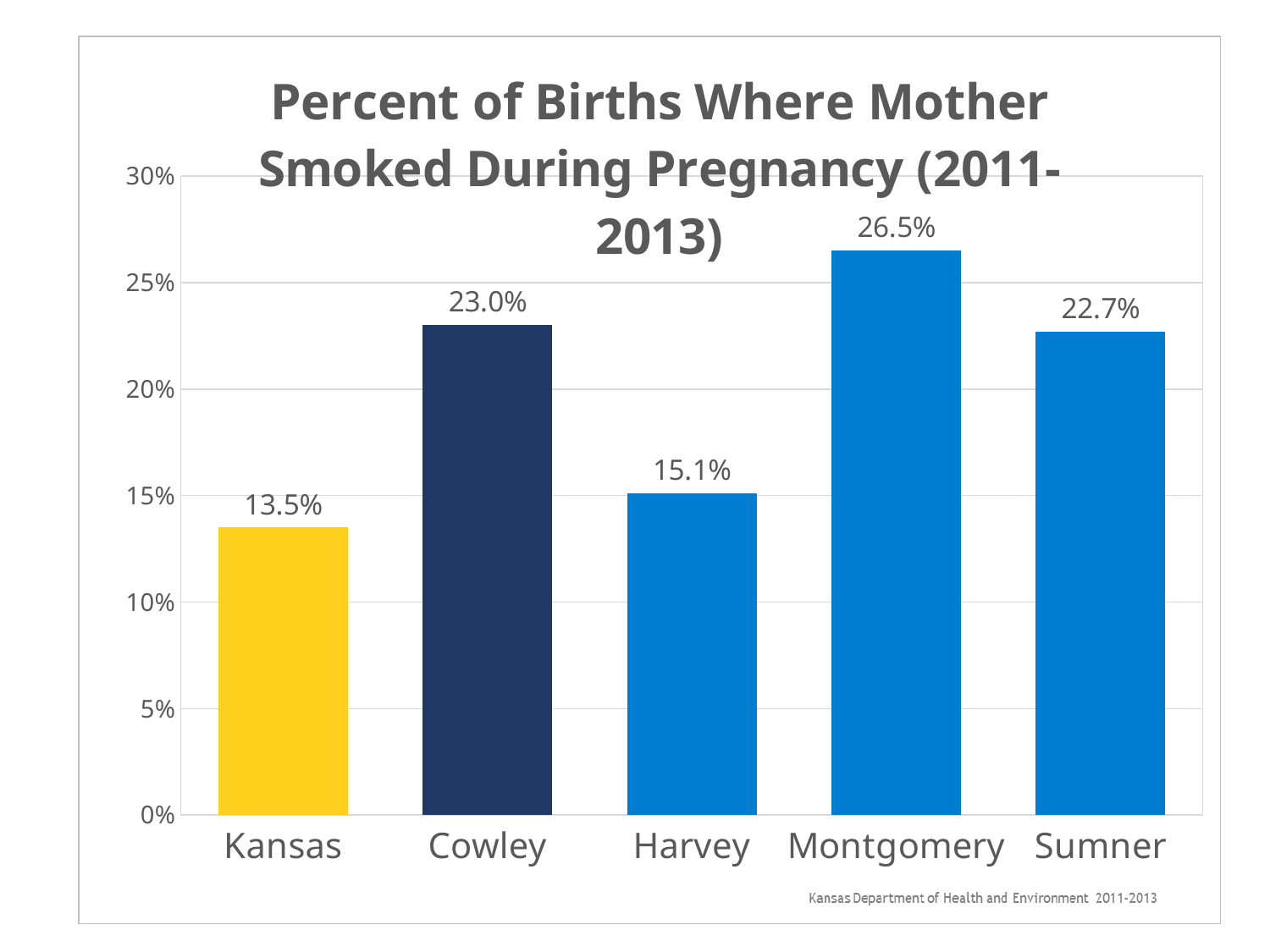
How many categories are shown on the chart? 5 Which has a higher value, Cowley or Harvey? Cowley What is the value shown for Montgomery? 26.5% What is the difference in percentage points between Cowley and Sumner? 0.3 What is the difference in percentage points between Montgomery and Kansas? 13.0 What is the value shown for Harvey? 15.1% Is the value for Harvey greater or less than 20%? less Which category has the highest percent of births where the mother smoked during pregnancy? Montgomery What is the percent of births where the mother smoked during pregnancy for Kansas? 13.5% What is the value shown for Sumner? 22.7% Which category has the lowest percent of births where the mother smoked during pregnancy? Kansas What kind of chart is shown on the slide? Bar chart